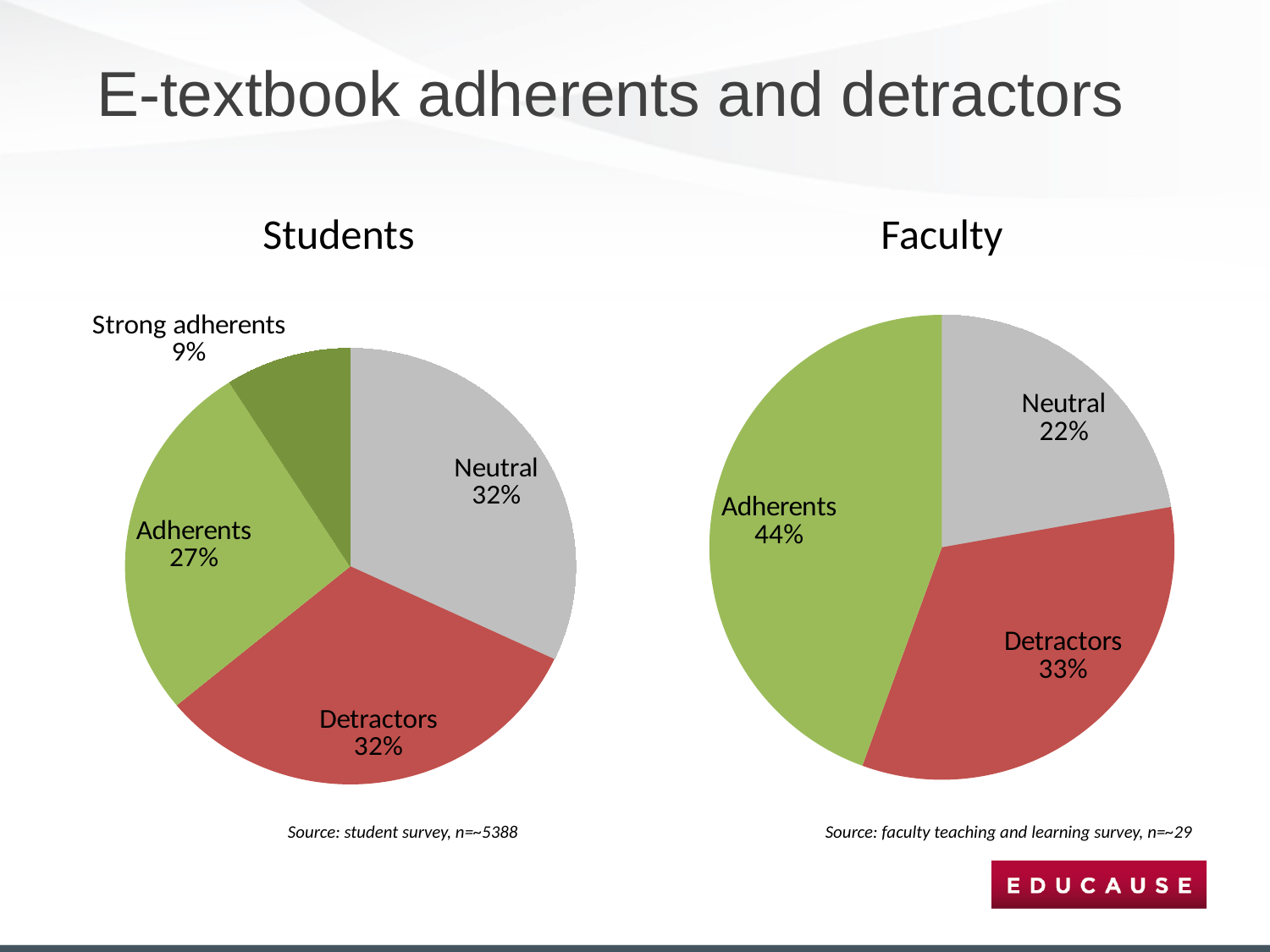
In the Faculty chart, what is the difference between the Adherents and Detractors shares? 11% In the Students chart, what percentage are Strong adherents? 9% How many categories does the Students chart show? 4 Which is larger: the Detractors share in the Students chart or the Detractors share in the Faculty chart? Faculty In the Faculty chart, which category has the smallest share? Neutral What type of chart is used for the Faculty data? Pie chart In the Students chart, which category has the smallest share? Strong adherents In the Faculty chart, what percentage are Neutral? 22% In the Students chart, what is the difference between the Neutral and Strong adherents shares? 23% In the Faculty chart, which category has the largest share? Adherents In the Students chart, what percentage are Adherents? 27% In the Faculty chart, what percentage are Adherents? 44%